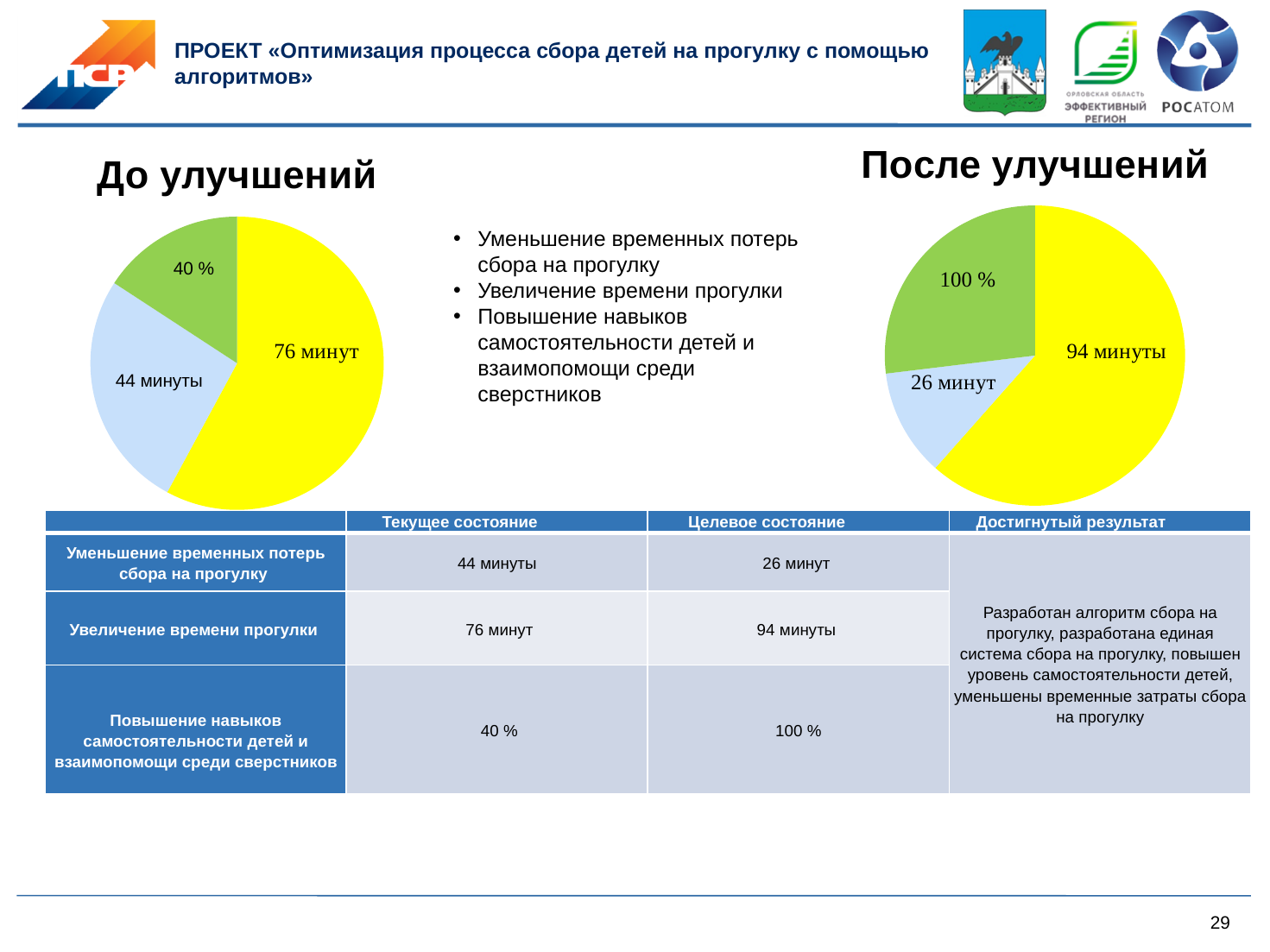
In the «До улучшений» pie chart, what value is printed on the yellow slice? 76 минут In the «После улучшений» pie chart, what value is printed on the green slice? 100 % How many slices does the «После улучшений» pie chart have? 3 In the «После улучшений» pie chart, what colour is the slice labelled 100 %? green In the «До улучшений» pie chart, what is the difference in minutes between the yellow slice (76 минут) and the light blue slice (44 минуты)? 32 минуты In the «После улучшений» pie chart, which is larger: the yellow slice or the light blue slice? the yellow slice In the «До улучшений» pie chart, what value is printed on the green slice? 40 % In the «После улучшений» pie chart, what value is printed on the yellow slice? 94 минуты In the «До улучшений» pie chart, what value is printed on the light blue slice? 44 минуты What kind of chart is used under the heading «До улучшений»? pie chart In the «До улучшений» pie chart, which slice is the largest? the yellow slice (76 минут) In the «После улучшений» pie chart, what value is printed on the light blue slice? 26 минут